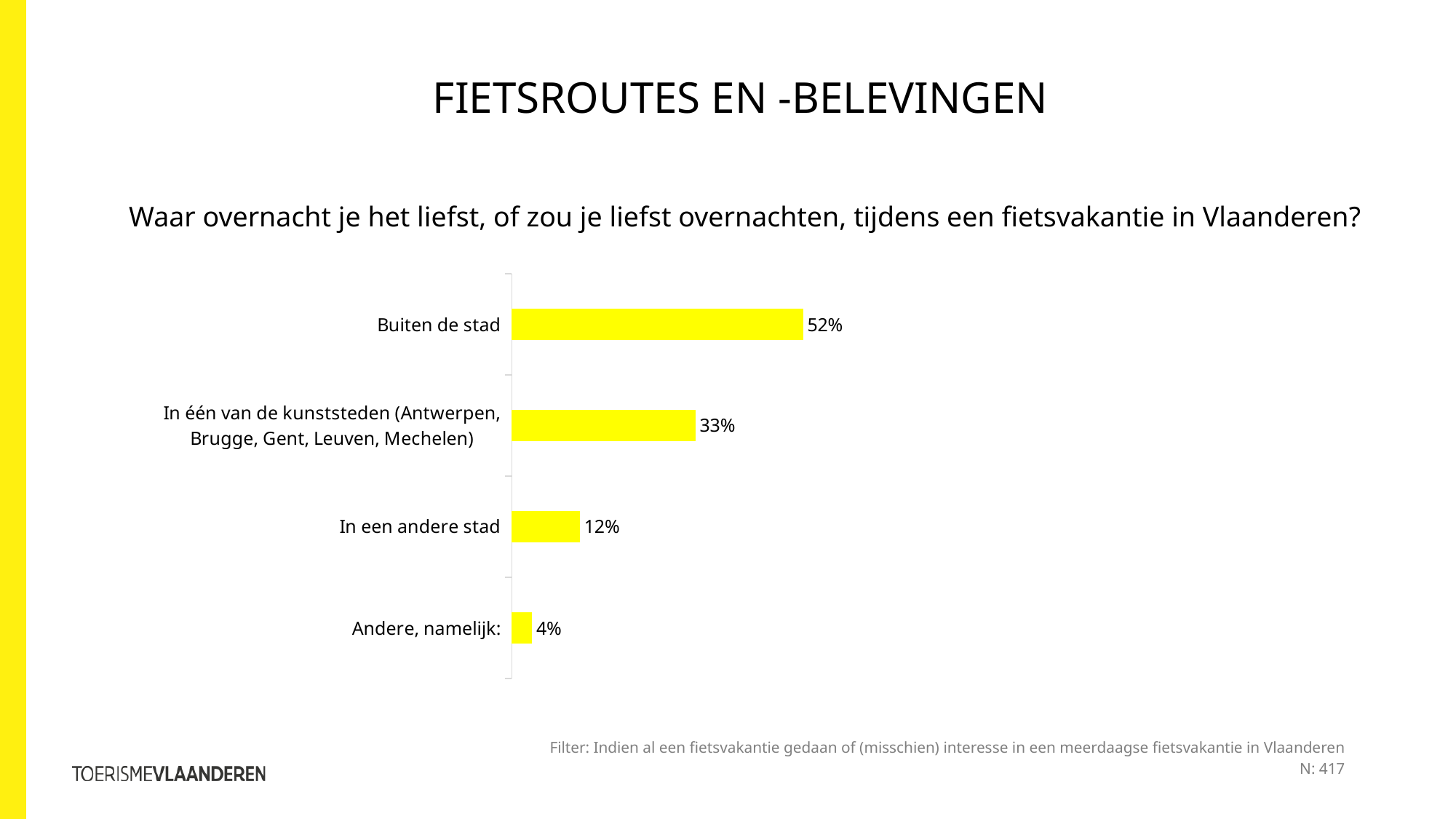
Which category has the highest value? Buiten de stad What is the value for "Buiten de stad"? 52% What is the value for "In één van de kunststeden (Antwerpen, Brugge, Gent, Leuven, Mechelen)"? 33% Which is larger: the value for "In een andere stad" or the value for "In één van de kunststeden"? In één van de kunststeden Which category has the lowest value? Andere, namelijk: What is the difference between the values for "In een andere stad" and "Andere, namelijk:"? 8% What is the value for "Andere, namelijk:"? 4% What colour are the bars in the chart? Yellow What is the value for "In een andere stad"? 12% How many categories are shown in the chart? 4 What kind of chart is shown on the slide? Bar chart What is the difference between the values for "Buiten de stad" and "In één van de kunststeden"? 19%